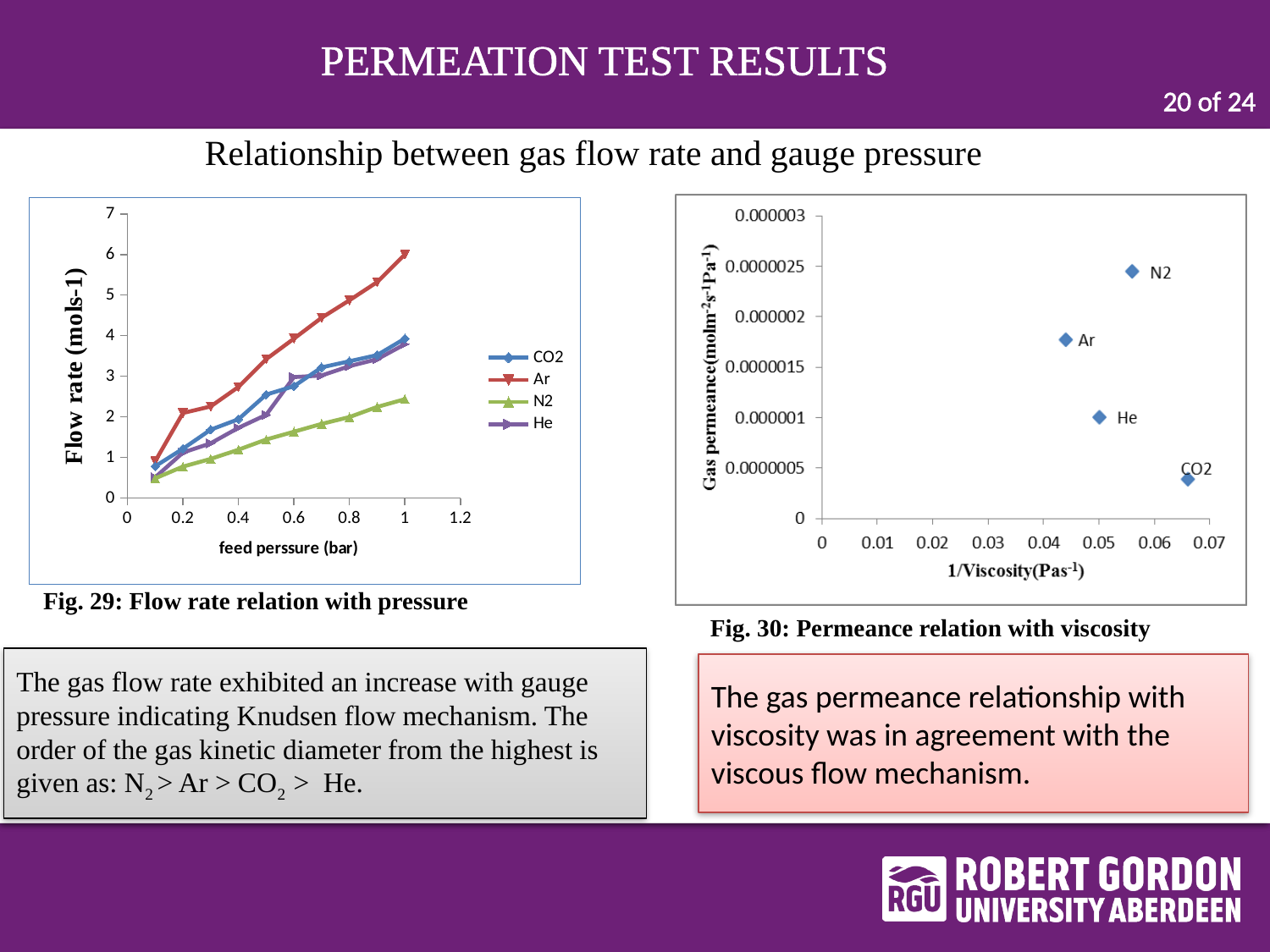
In Fig. 29 (Flow rate relation with pressure), which gas has the lowest flow rate at a feed pressure of 1 bar? N2 In Fig. 30 (Permeance relation with viscosity), is the gas permeance for N2 greater or less than 0.000002? greater In Fig. 29 (Flow rate relation with pressure), is the flow rate for N2 at 1 bar greater or less than 3? less In Fig. 30 (Permeance relation with viscosity), which gas has the lowest gas permeance? CO2 In Fig. 29 (Flow rate relation with pressure), how many series does the legend list? 4 In Fig. 29 (Flow rate relation with pressure), at a feed pressure of 0.6 bar, which has the larger flow rate, Ar or N2? Ar In Fig. 29 (Flow rate relation with pressure), is the flow rate for Ar at 1 bar greater or less than 5? greater In Fig. 29 (Flow rate relation with pressure), what kind of chart is shown? line chart In Fig. 30 (Permeance relation with viscosity), which gas has the highest gas permeance? N2 In Fig. 29 (Flow rate relation with pressure), which gas has the highest flow rate at a feed pressure of 1 bar? Ar In Fig. 29 (Flow rate relation with pressure), do the flow rates rise or fall as feed pressure increases? rise In Fig. 30 (Permeance relation with viscosity), what kind of chart is shown? scatter chart